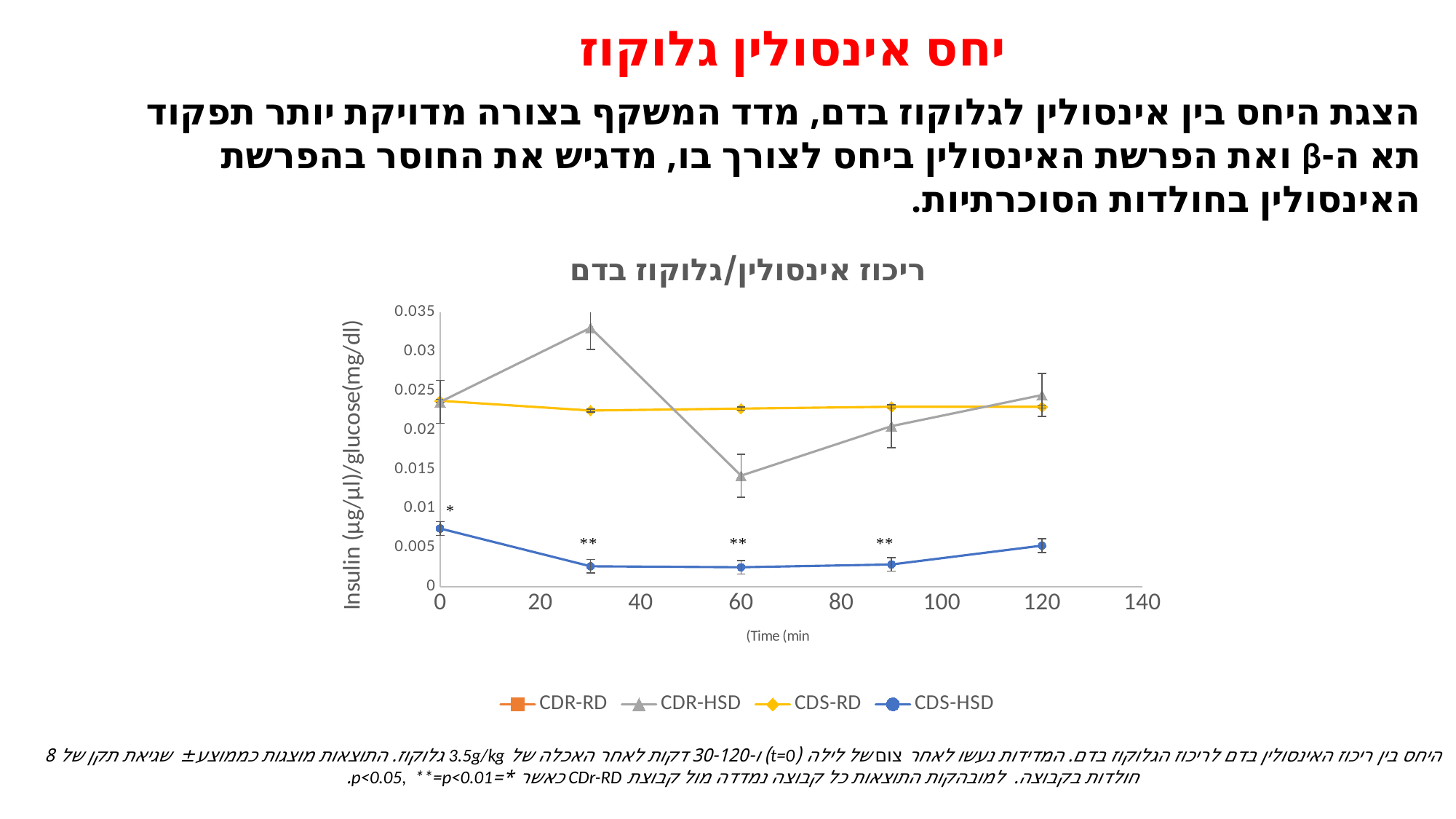
What kind of chart is shown on the slide? line chart Is the value for CDS-HSD at 0 min greater or less than 0.01? less At 60 min, which series has the larger value: CDS-RD or CDR-HSD? CDS-RD Is the value for CDR-HSD at 60 min greater or less than 0.02? less How many time points are plotted for the CDS-HSD series? 5 At which time (min) does the CDR-HSD series reach its highest value? 30 Is the value for CDR-HSD at 30 min greater or less than 0.03? greater How many series does the legend list? 4 At 30 min, which series has the larger value: CDR-HSD or CDS-RD? CDR-HSD What is the label of the x axis? Time (min) At which time (min) does the CDR-HSD series reach its lowest value? 60 Does the CDS-HSD series rise or fall between 0 and 30 min? fall